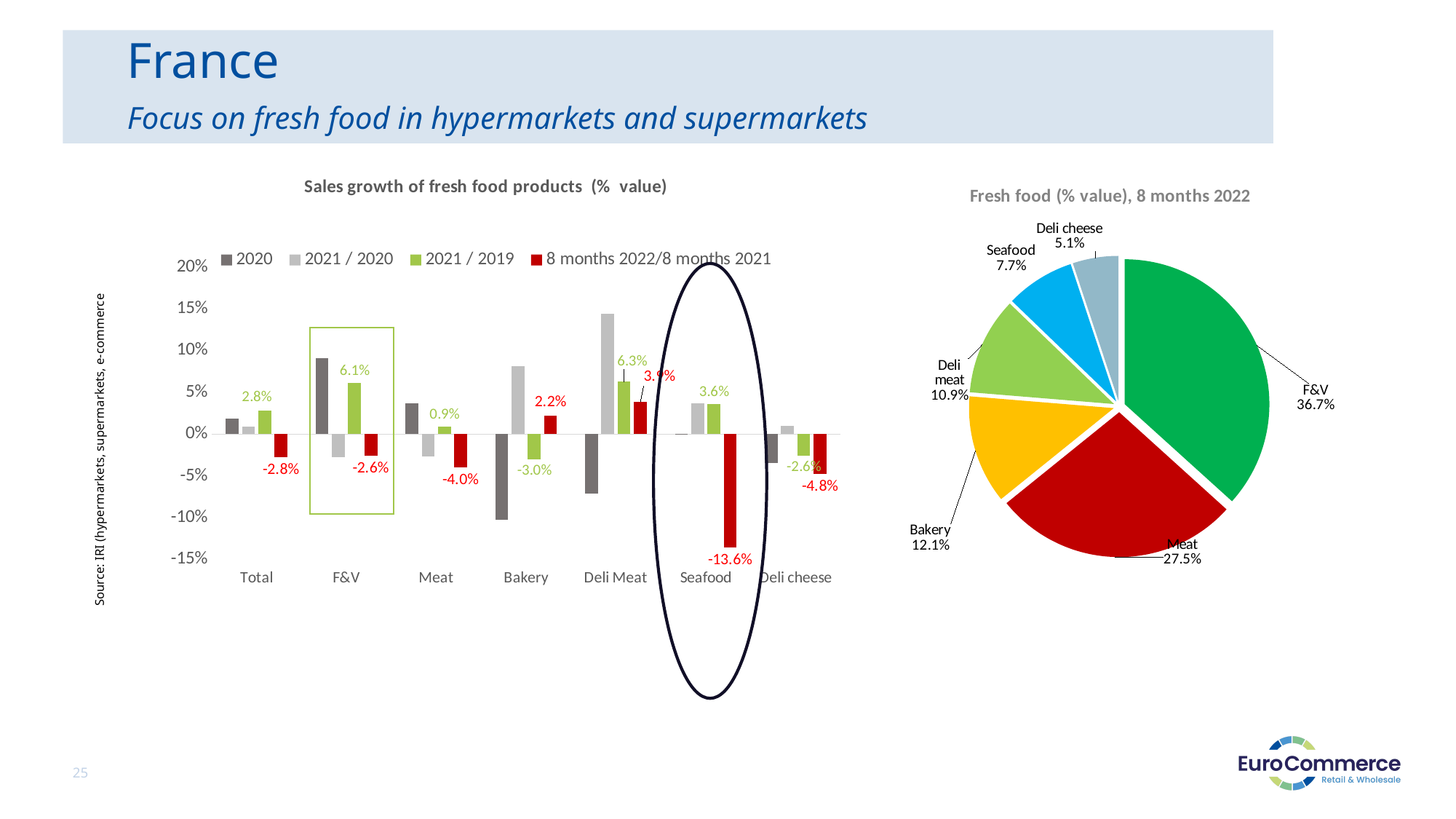
In the 'Sales growth of fresh food products' chart, which category has the highest 2021 / 2019 value? Deli Meat In the 'Fresh food (% value), 8 months 2022' pie chart, what share does Meat have? 27.5% In the 'Sales growth of fresh food products' chart, what is the 8 months 2022/8 months 2021 value for Seafood? -13.6% In the 'Fresh food (% value), 8 months 2022' pie chart, which slice is the smallest? Deli cheese In the 'Sales growth of fresh food products' chart, which category has the lowest 8 months 2022/8 months 2021 value? Seafood In the 'Sales growth of fresh food products' chart, what is the difference between the 2021 / 2019 value and the 8 months 2022/8 months 2021 value for Total? 5.6 percentage points What kind of chart is the 'Sales growth of fresh food products' chart? Bar chart In the 'Sales growth of fresh food products' chart, which is larger for 8 months 2022/8 months 2021: Bakery or Meat? Bakery In the 'Sales growth of fresh food products' chart, what is the 2021 / 2019 value for F&V? 6.1% How many categories are shown on the x axis of the 'Sales growth of fresh food products' chart? 7 How many series does the legend of the 'Sales growth of fresh food products' chart list? 4 In the 'Sales growth of fresh food products' chart, is the 2021 / 2020 value for Deli Meat greater or less than 10%? greater